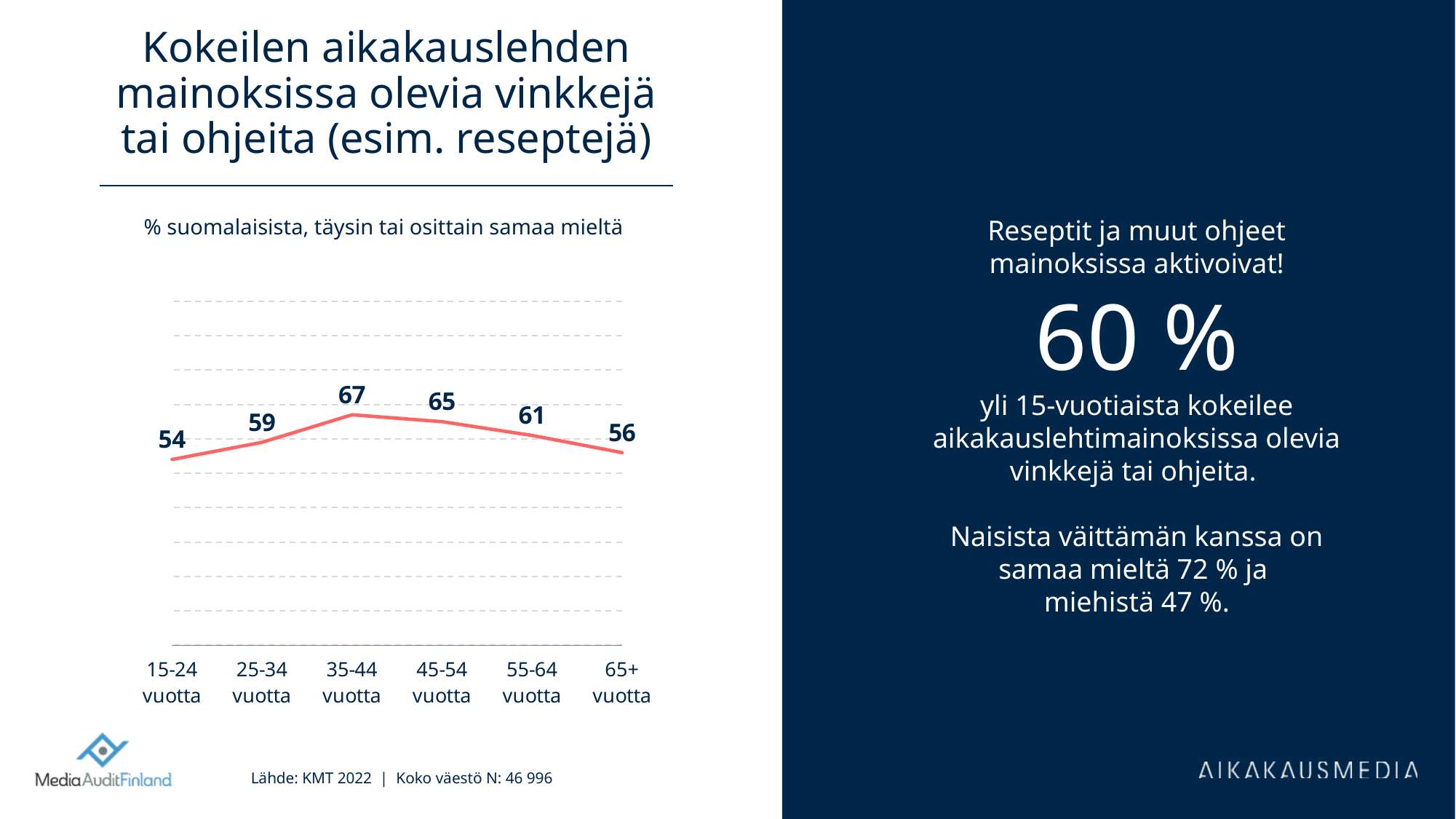
What is the value for the 35-44 vuotta age group? 67 How many age groups are plotted on the chart? 6 Which is larger, the value for 25-34 vuotta or the value for 55-64 vuotta? 55-64 vuotta Do the values rise or fall from 35-44 vuotta to 65+ vuotta? Fall What is the difference between the values for 45-54 vuotta and 65+ vuotta? 9 What is the value for the 15-24 vuotta age group? 54 Which age group has the lowest value? 15-24 vuotta What kind of chart is shown on the slide? Line chart Which age group has the highest value? 35-44 vuotta What is the value for the 65+ vuotta age group? 56 What is the difference between the values for 35-44 vuotta and 15-24 vuotta? 13 What is the value for the 55-64 vuotta age group? 61